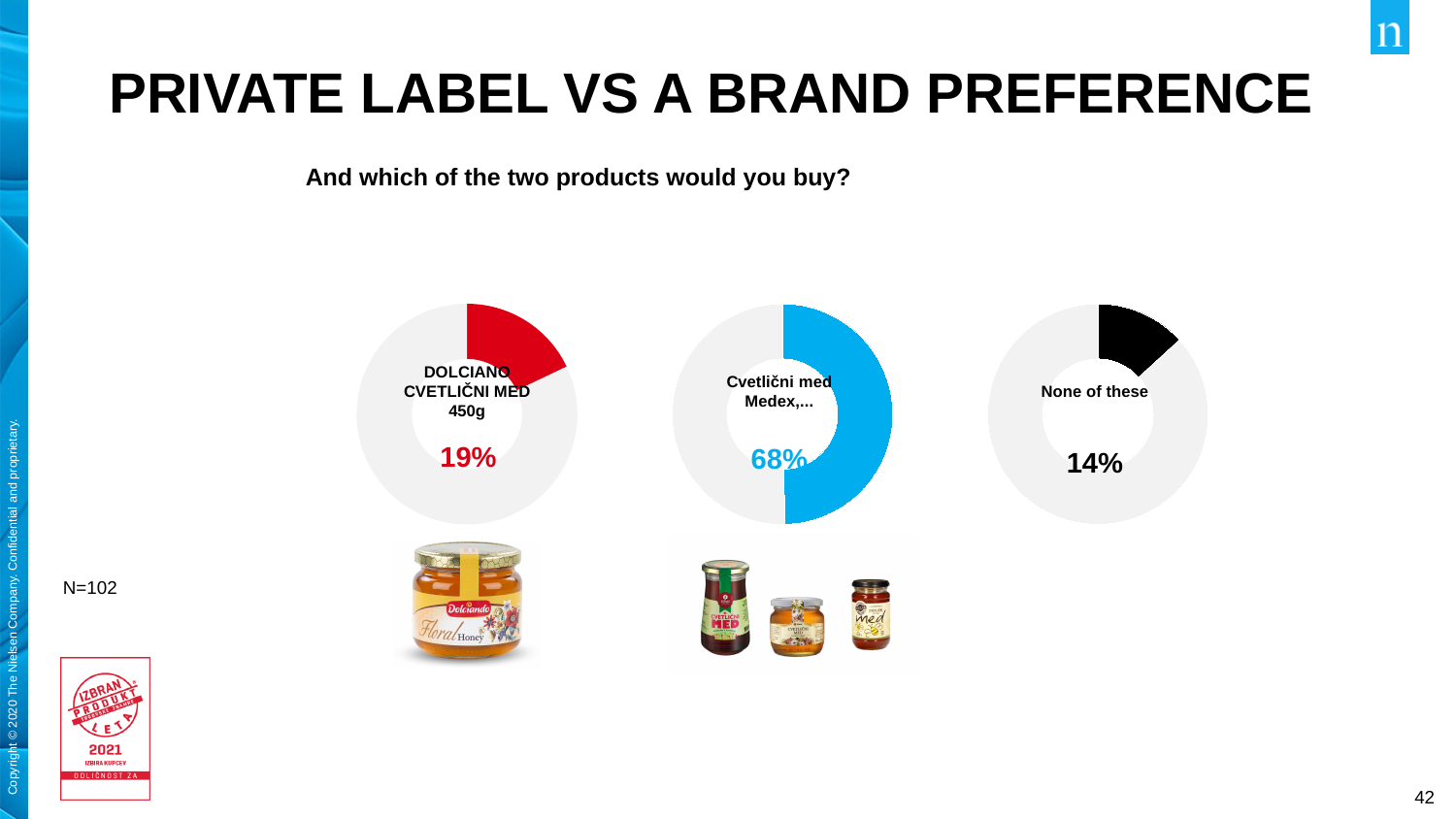
What colour is the filled segment in the middle donut chart for Cvetlični med Medex? Blue How many donut charts are shown on the slide? 3 What type of chart is used to show the share for each option on the slide? Donut (pie) chart What is the sample size (N) stated on the slide? N=102 Across the three donut charts, which option has the highest share? Cvetlični med Medex Across the three donut charts, which option has the lowest share? None of these In the middle donut chart, what share of respondents would buy Cvetlični med Medex? 68% In the left donut chart, what share of respondents would buy DOLCIANO CVETLIČNI MED 450g? 19% What is the difference between the share for DOLCIANO CVETLIČNI MED 450g (left chart) and the share for None of these (right chart)? 5 percentage points What is the difference between the share for Cvetlični med Medex (middle chart) and the share for DOLCIANO CVETLIČNI MED 450g (left chart)? 49 percentage points Comparing the left and middle donut charts, which is larger: the share for DOLCIANO CVETLIČNI MED 450g or for Cvetlični med Medex? Cvetlični med Medex In the right donut chart, what share of respondents chose None of these? 14%